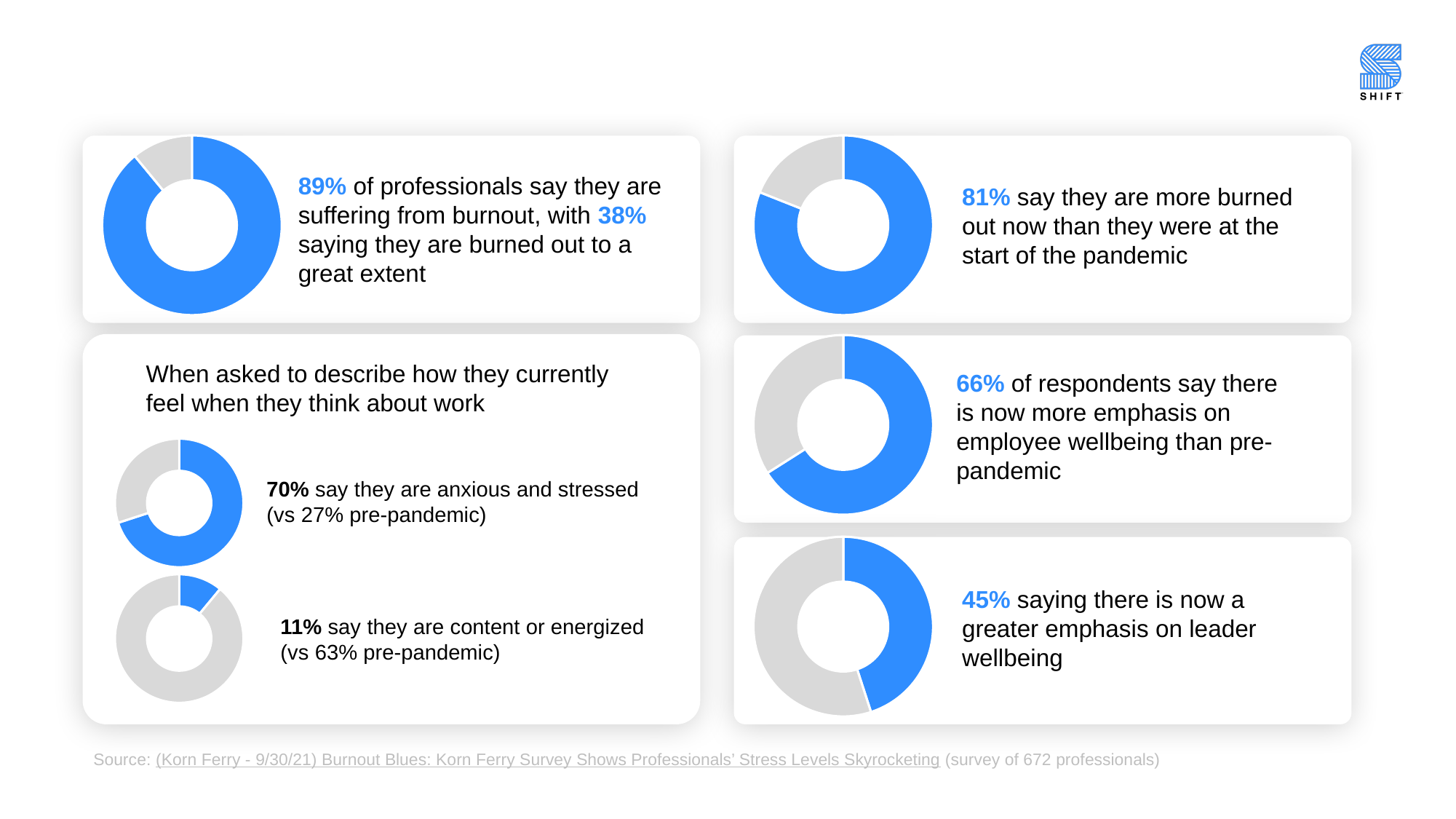
What colour is used for the highlighted portion of each donut chart? Blue How many donut charts are shown on the slide? 6 What is the difference in percentage points between the top-left chart value (89%) and the top-right chart value (81%)? 8 percentage points In the bottom-right donut chart, what percentage say there is now a greater emphasis on leader wellbeing? 45% What is the difference in percentage points between the share saying they are anxious and stressed (70%) and the share saying they are content or energized (11%)? 59 percentage points In the donut chart about feeling anxious and stressed, what share of the ring is highlighted in blue? 70% In the top-left donut chart, what percentage of professionals say they are suffering from burnout? 89% In the middle-right donut chart, what percentage of respondents say there is now more emphasis on employee wellbeing than pre-pandemic? 66% In the top-right donut chart, what percentage say they are more burned out now than at the start of the pandemic? 81% In the donut chart about feeling content or energized, what percentage is shown? 11% Which is larger: the percentage saying they are anxious and stressed or the percentage saying they are content or energized? Anxious and stressed What kind of chart is used throughout this slide? Donut chart